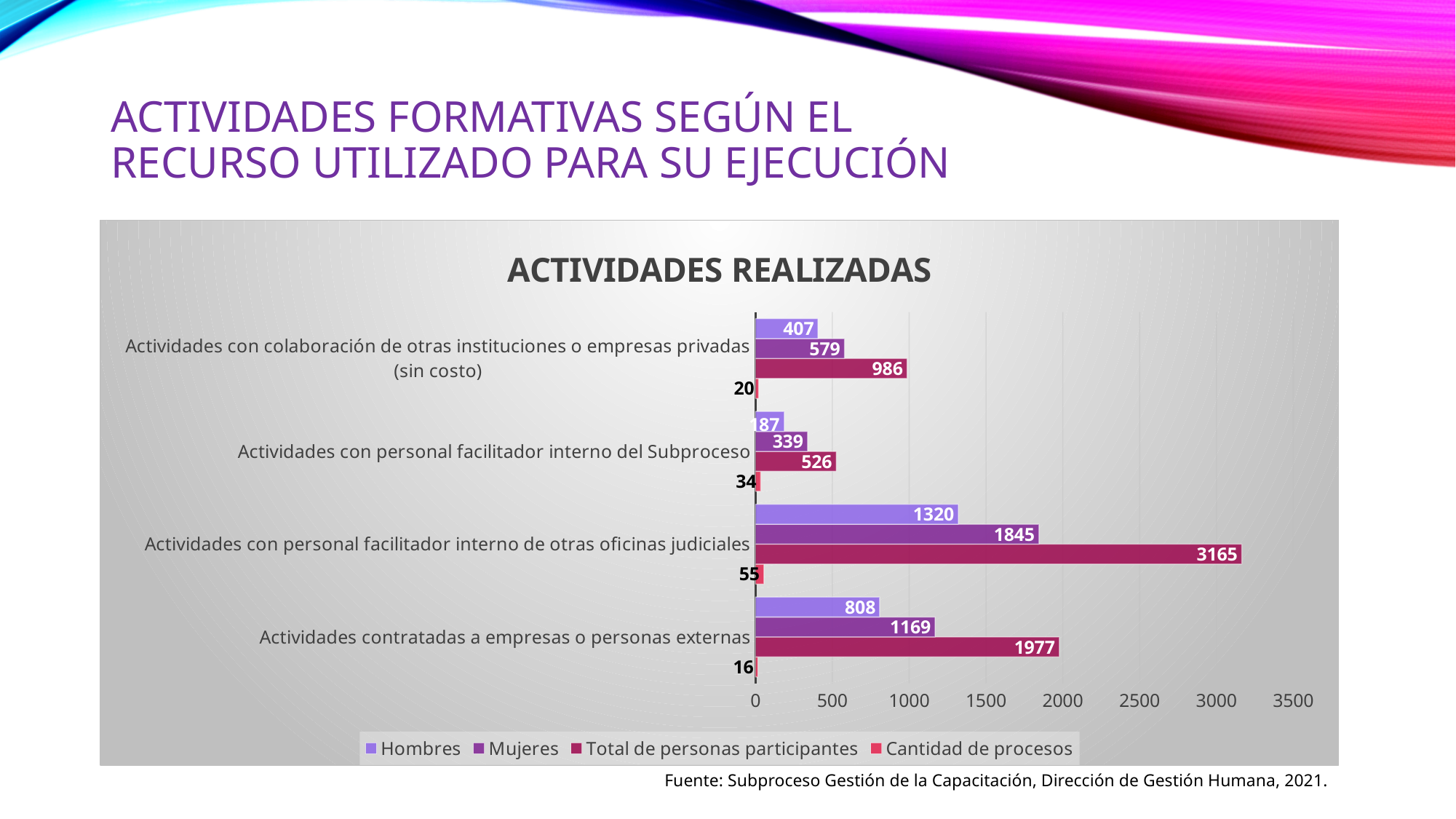
What kind of chart is shown on the slide? Bar chart Which category has the highest value for Total de personas participantes? Actividades con personal facilitador interno de otras oficinas judiciales What is the value of Total de personas participantes for 'Actividades con personal facilitador interno de otras oficinas judiciales'? 3165 What is the title of the chart? ACTIVIDADES REALIZADAS How many series does the legend list? 4 Which category has the lowest value for Cantidad de procesos? Actividades contratadas a empresas o personas externas What is the value of Mujeres for 'Actividades con colaboración de otras instituciones o empresas privadas (sin costo)'? 579 Which is larger: Total de personas participantes for 'Actividades con colaboración de otras instituciones o empresas privadas (sin costo)' or for 'Actividades con personal facilitador interno del Subproceso'? Actividades con colaboración de otras instituciones o empresas privadas (sin costo) How many categories are shown on the y axis of the chart? 4 What is the value of Hombres for 'Actividades contratadas a empresas o personas externas'? 808 What is the difference between Mujeres and Hombres for 'Actividades contratadas a empresas o personas externas'? 361 What is the value of Cantidad de procesos for 'Actividades con personal facilitador interno del Subproceso'? 34